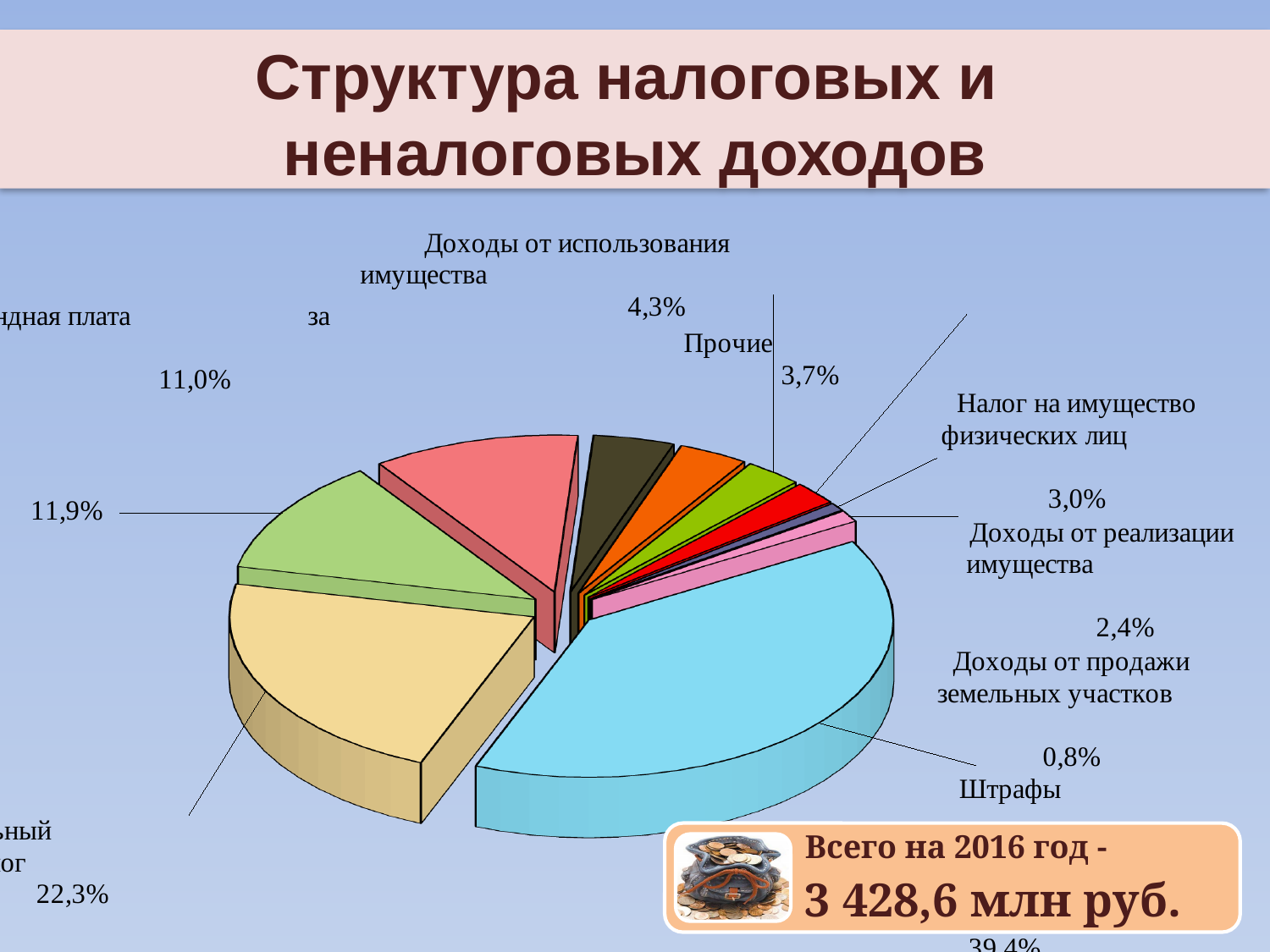
What share does "Прочие" have in the pie chart? 3,7% What share does "Доходы от реализации имущества" have in the pie chart? 2,4% Which is larger in the pie chart: "Прочие" or "Налог на имущество физических лиц"? Прочие What kind of chart is shown on the slide? pie chart What is the difference between the shares of "Налог на имущество физических лиц" and "Доходы от реализации имущества"? 0,6% Which labelled category has the smallest share in the pie chart? Доходы от продажи земельных участков What total amount for 2016 is stated in the box on the slide? 3 428,6 млн руб. What share does "Доходы от продажи земельных участков" have in the pie chart? 0,8% What is the difference between the shares of "Доходы от использования имущества" and "Прочие"? 0,6% Which is larger in the pie chart: "Доходы от реализации имущества" or "Доходы от использования имущества"? Доходы от использования имущества What share does "Доходы от использования имущества" have in the pie chart? 4,3% What share does "Налог на имущество физических лиц" have in the pie chart? 3,0%